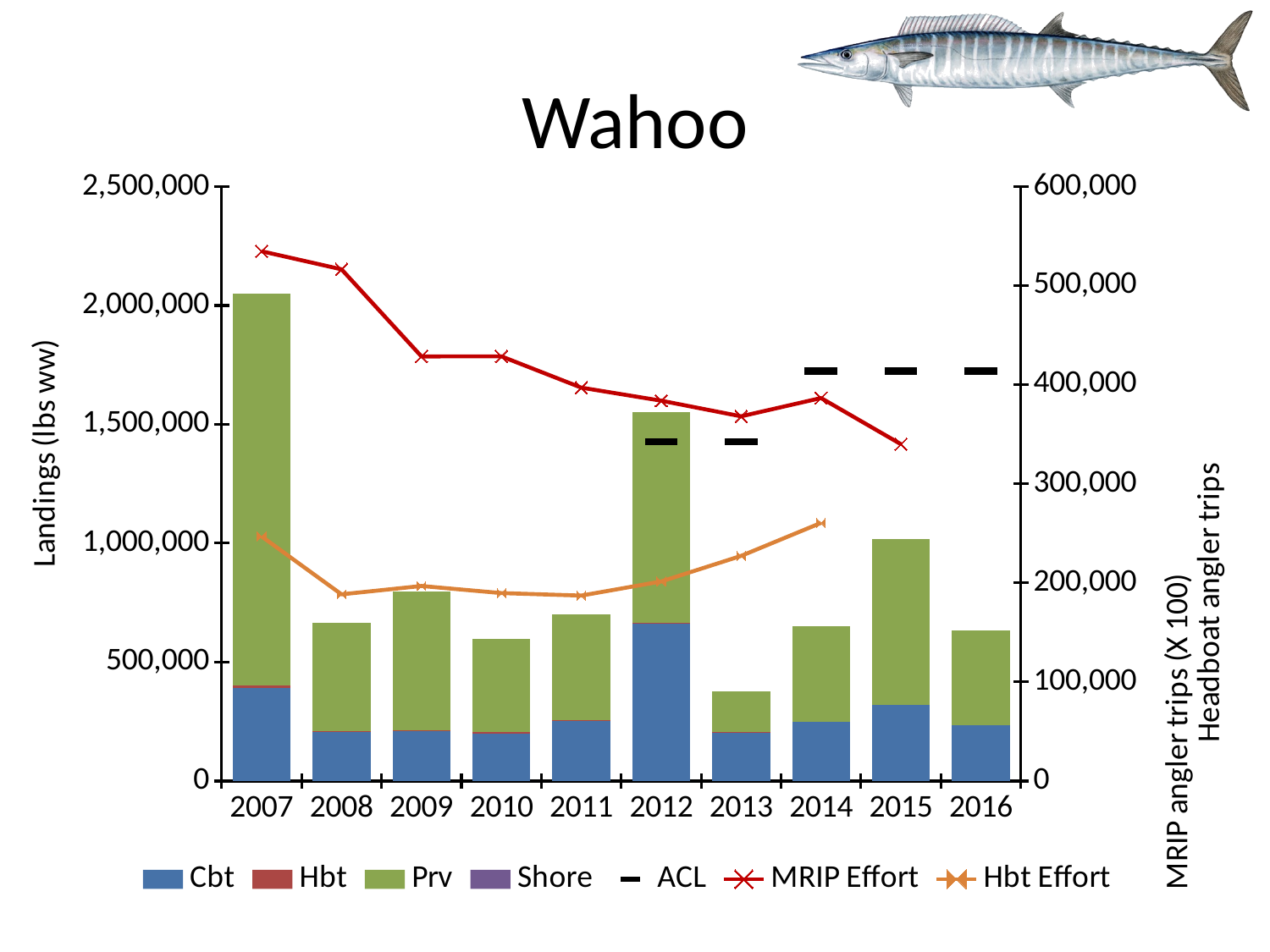
Which year has a larger Cbt value, 2007 or 2012? 2012 How many years are shown on the x axis? 10 Is the MRIP Effort value for 2007 greater or less than 500,000 on the right axis? greater Is the total landings value for 2007 greater or less than 1,500,000? greater Is the total landings value for 2013 greater or less than 500,000? less What is the title of the chart? Wahoo Which year has the lowest total landings? 2013 Does the MRIP Effort line generally rise or fall from 2007 to 2015? fall How many series does the legend list? 7 Which year has the highest total landings? 2007 Which year has larger total landings, 2014 or 2015? 2015 What kind of chart is shown on the slide? Stacked bar chart with line series